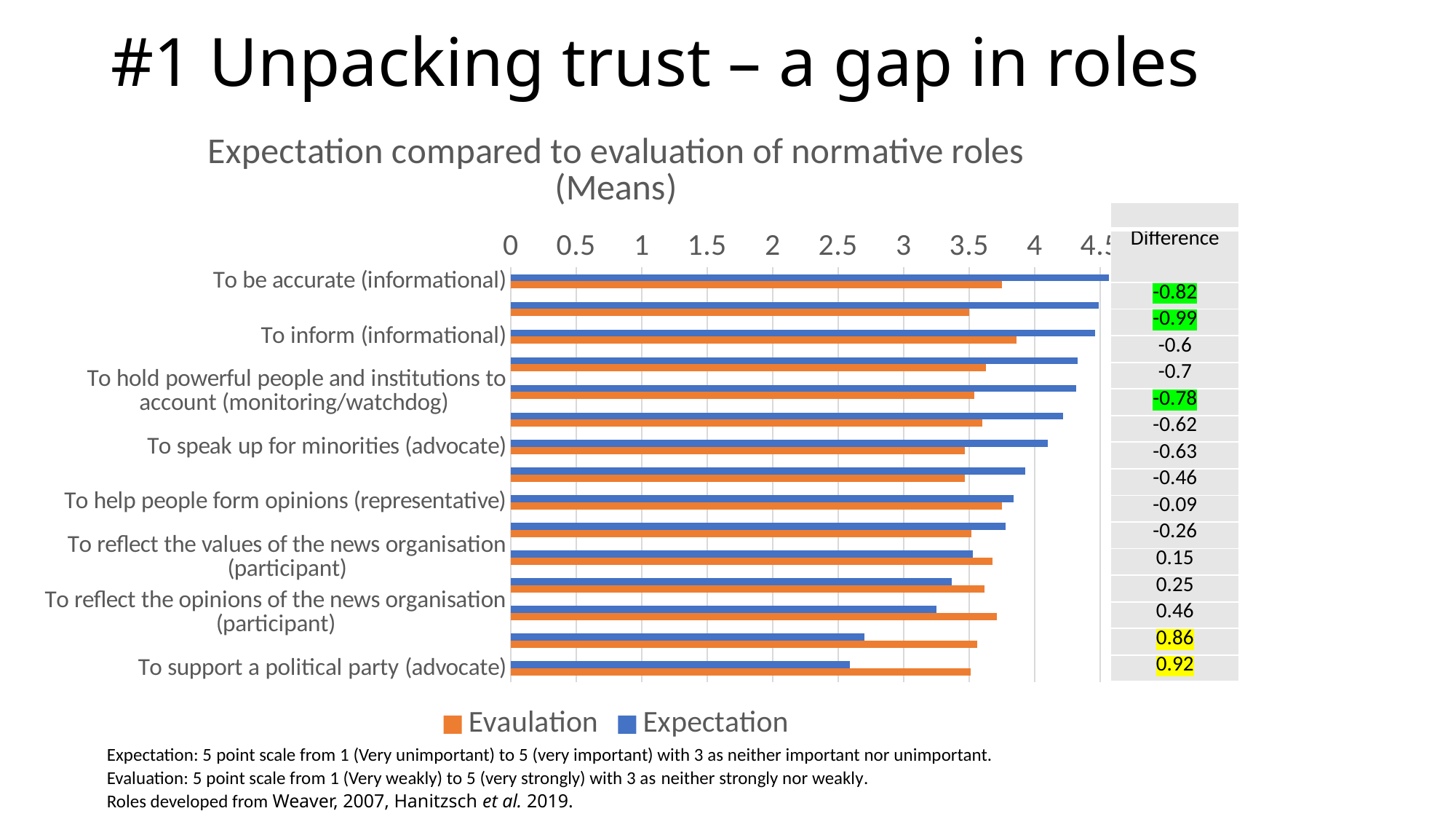
What is the title of the chart? Expectation compared to evaluation of normative roles (Means) For 'To be accurate (informational)', which is larger, the Expectation value or the Evaluation value? Expectation Is the Evaluation value for 'To support a political party (advocate)' greater or less than 3? greater What is the most negative value shown in the Difference column next to the chart? -0.99 What kind of chart is shown on the slide? bar chart For 'To support a political party (advocate)', which is larger, the Evaluation value or the Expectation value? Evaluation Is the Evaluation value for 'To be accurate (informational)' greater or less than 3.5? greater Is the Expectation value for 'To support a political party (advocate)' greater or less than 3? less Do the Expectation values rise or fall going from the top category to the bottom category? fall Which colour represents the Expectation series in the chart? blue How many series does the chart legend list? 2